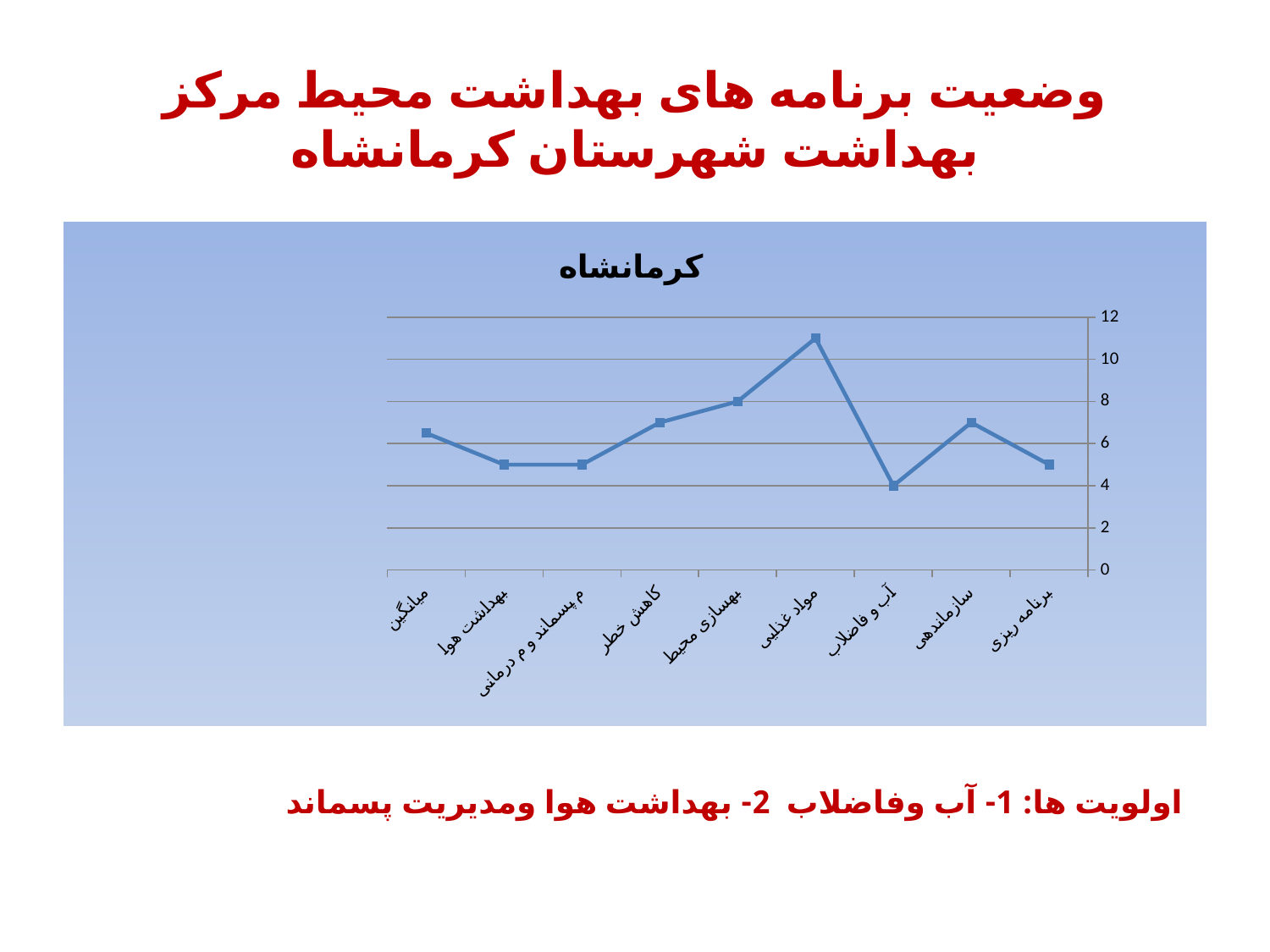
Is the value for کاهش خطر greater or less than 6? greater Is the value for مواد غذایی greater or less than 10? greater Which category has the highest value? مواد غذایی Which category has the lowest value? آب و فاضلاب How many categories are plotted along the x axis? 9 Does the line rise or fall between مواد غذایی and آب و فاضلاب? fall Is the value for برنامه ریزی greater or less than 6? less What is the title of the chart? کرمانشاه Which is larger, the value for بهسازی محیط or the value for بهداشت هوا? بهسازی محیط What kind of chart is shown on the slide? line chart Which is larger, the value for سازماندهی or the value for آب و فاضلاب? سازماندهی